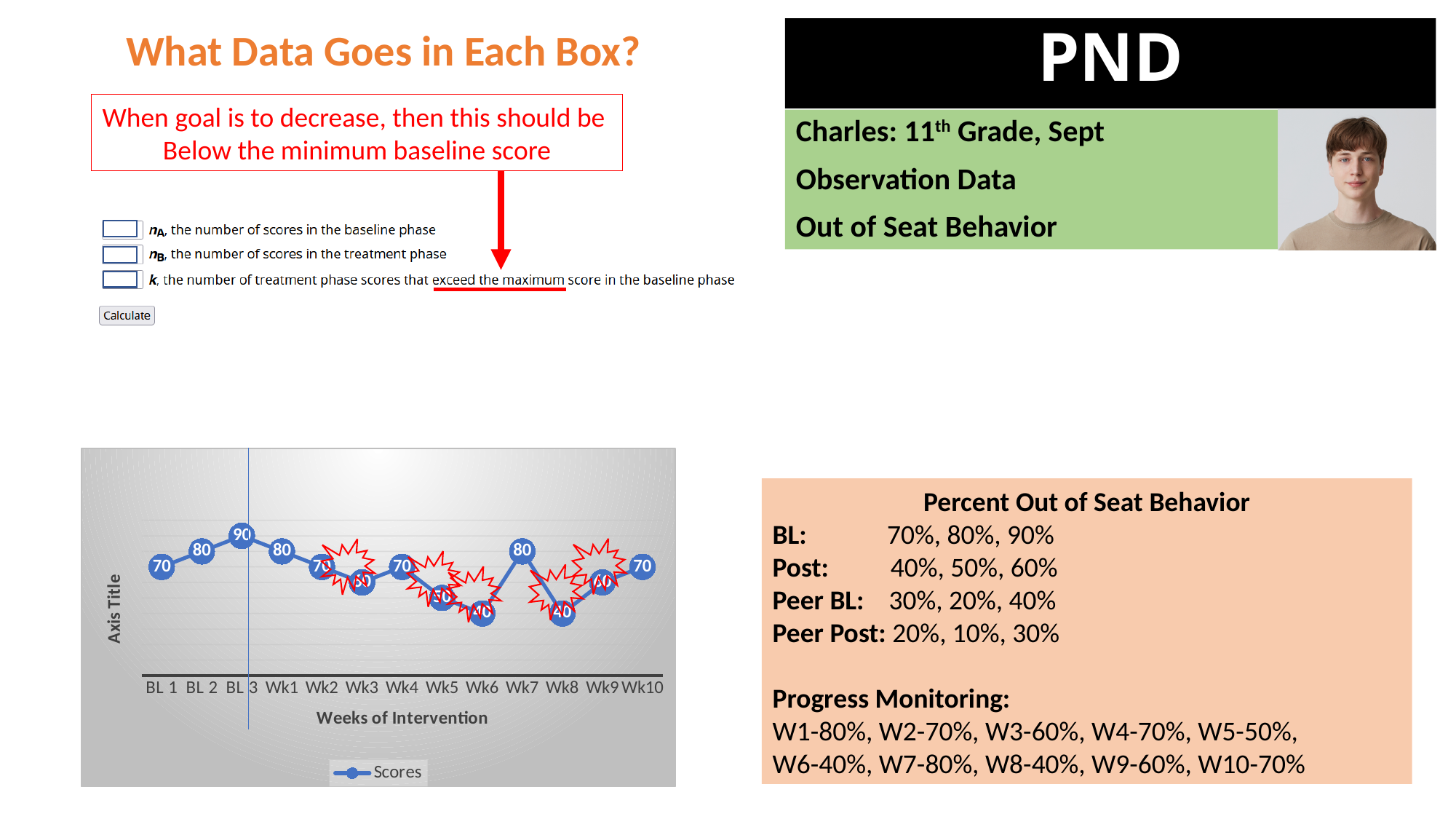
What is the difference between the values for BL 3 and Wk1? 10 What is the value for Wk7 in the chart? 80 Which is larger, the value for BL 2 or the value for Wk2? BL 2 How many data points are plotted in the chart? 13 How many series does the chart legend list? 1 Which category has the highest value in the chart? BL 3 What type of chart is shown on the slide? line chart What is the value for BL 1 in the chart? 70 What is the value for Wk10 in the chart? 70 What is the value for BL 3 in the chart? 90 What is the x-axis title of the chart? Weeks of Intervention What is the name of the series shown in the chart legend? Scores